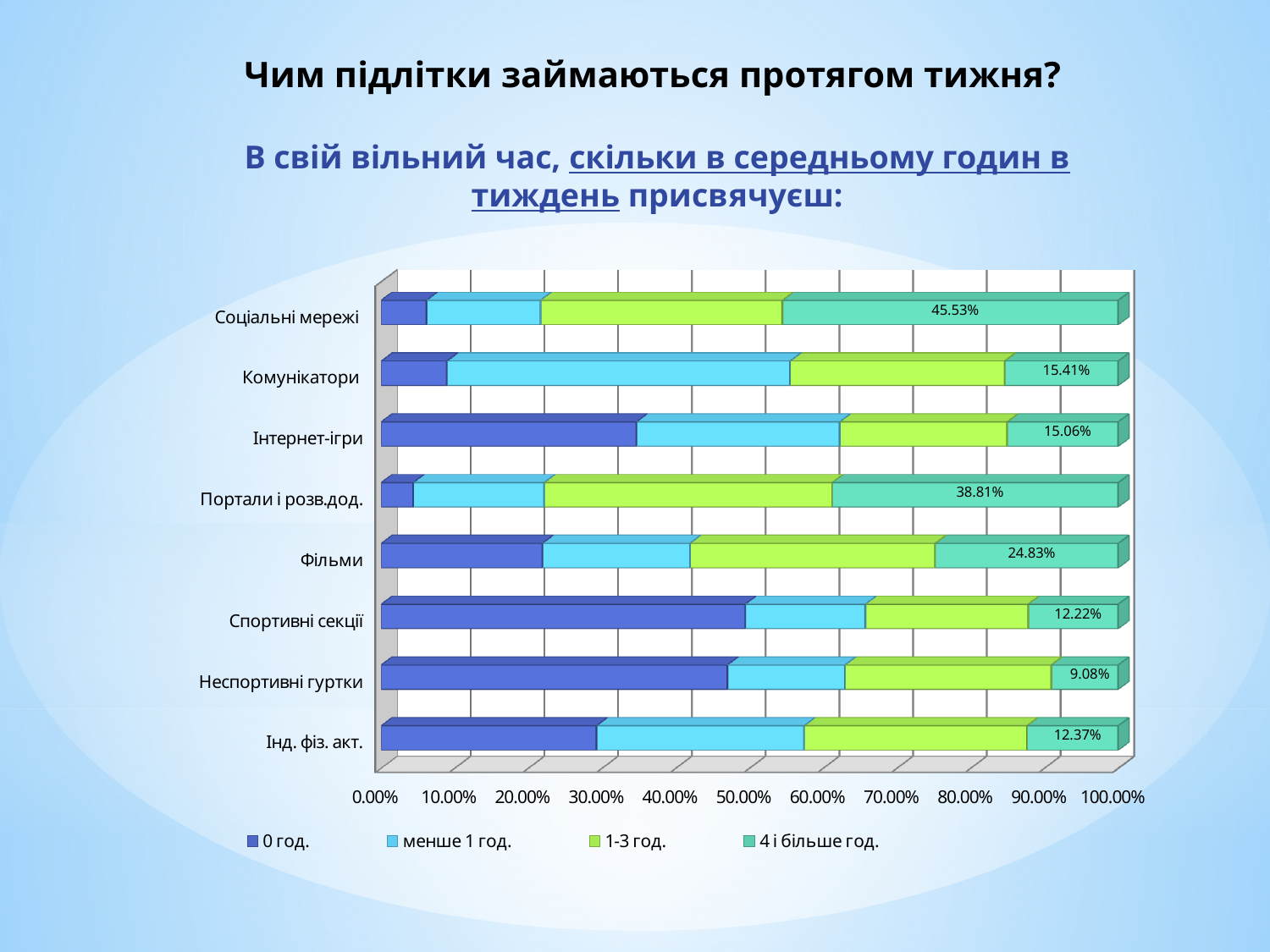
How many categories are shown on the chart? 8 What is the value for "4 і більше год." for Неспортивні гуртки? 9.08% Which category has the lowest value for "4 і більше год."? Неспортивні гуртки How many series does the legend list? 4 What kind of chart is shown on the slide? Stacked bar chart Which has a larger "4 і більше год." value: Фільми or Спортивні секції? Фільми Which category has the highest value for "4 і більше год."? Соціальні мережі Is the "0 год." value for Спортивні секції greater or less than 40.00%? greater What is the value for "4 і більше год." for Соціальні мережі? 45.53% What is the value for "4 і більше год." for Портали і розв.дод.? 38.81% What is the difference between the "4 і більше год." values for Соціальні мережі and Портали і розв.дод.? 6.72% Is the "0 год." value for Соціальні мережі greater or less than 10.00%? less